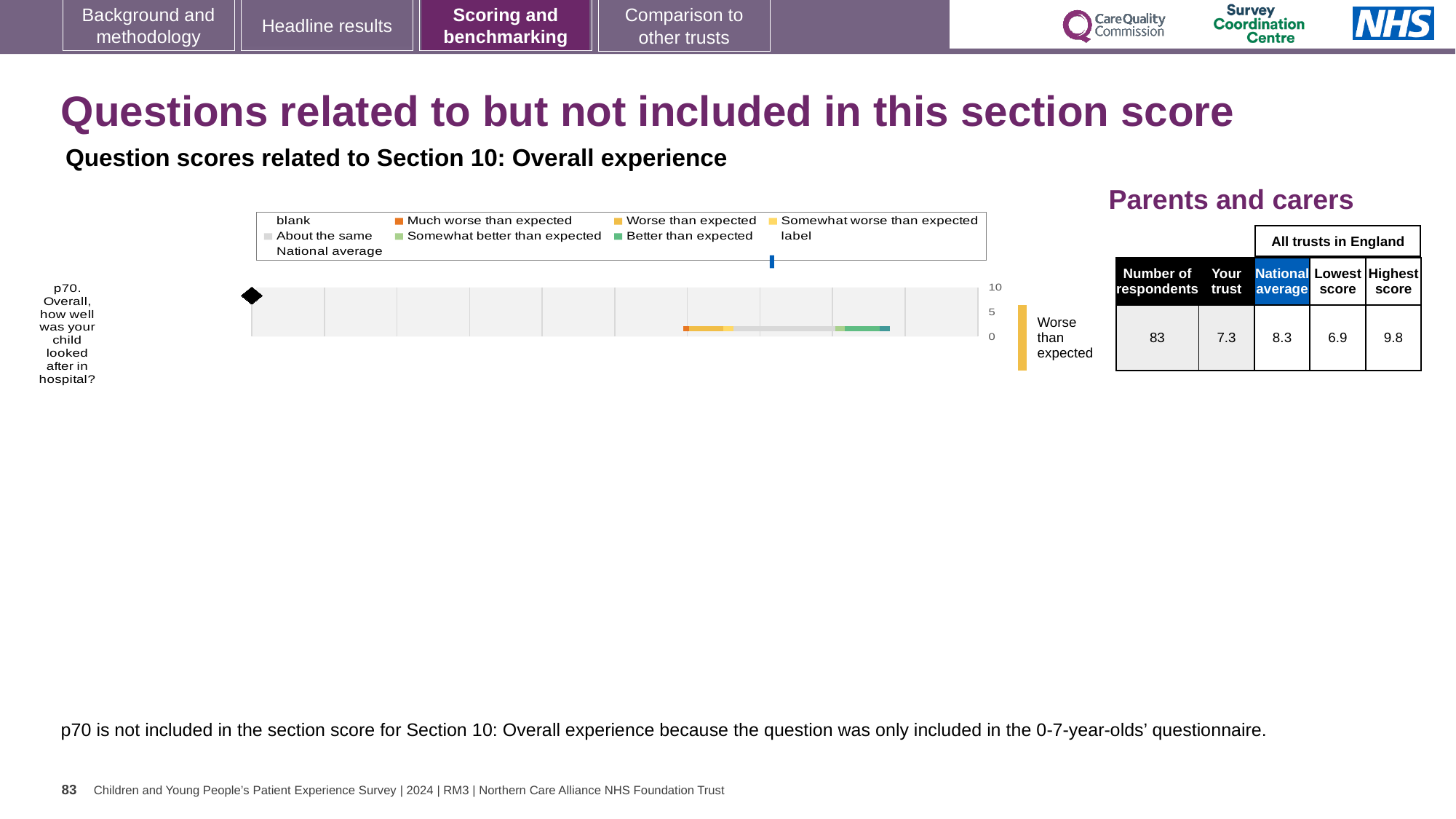
How many respondents answered question p70 according to the Parents and carers table? 83 What is the national average score for question p70 in the Parents and carers table? 8.3 What benchmark category is shown next to the chart for question p70? Worse than expected How many survey questions are plotted in the chart? 1 What is the 'Your trust' score for question p70 in the Parents and carers table? 7.3 Which question is plotted in the chart? p70. Overall, how well was your child looked after in hospital? Which is larger for question p70, the 'Your trust' score or the national average? national average What is the difference between the national average and the 'Your trust' score for question p70? 1.0 What is the highest score among all trusts in England for question p70? 9.8 What is the lowest score among all trusts in England for question p70? 6.9 What is the highest value shown on the chart's axis? 10 What kind of chart is shown on the slide? bar chart